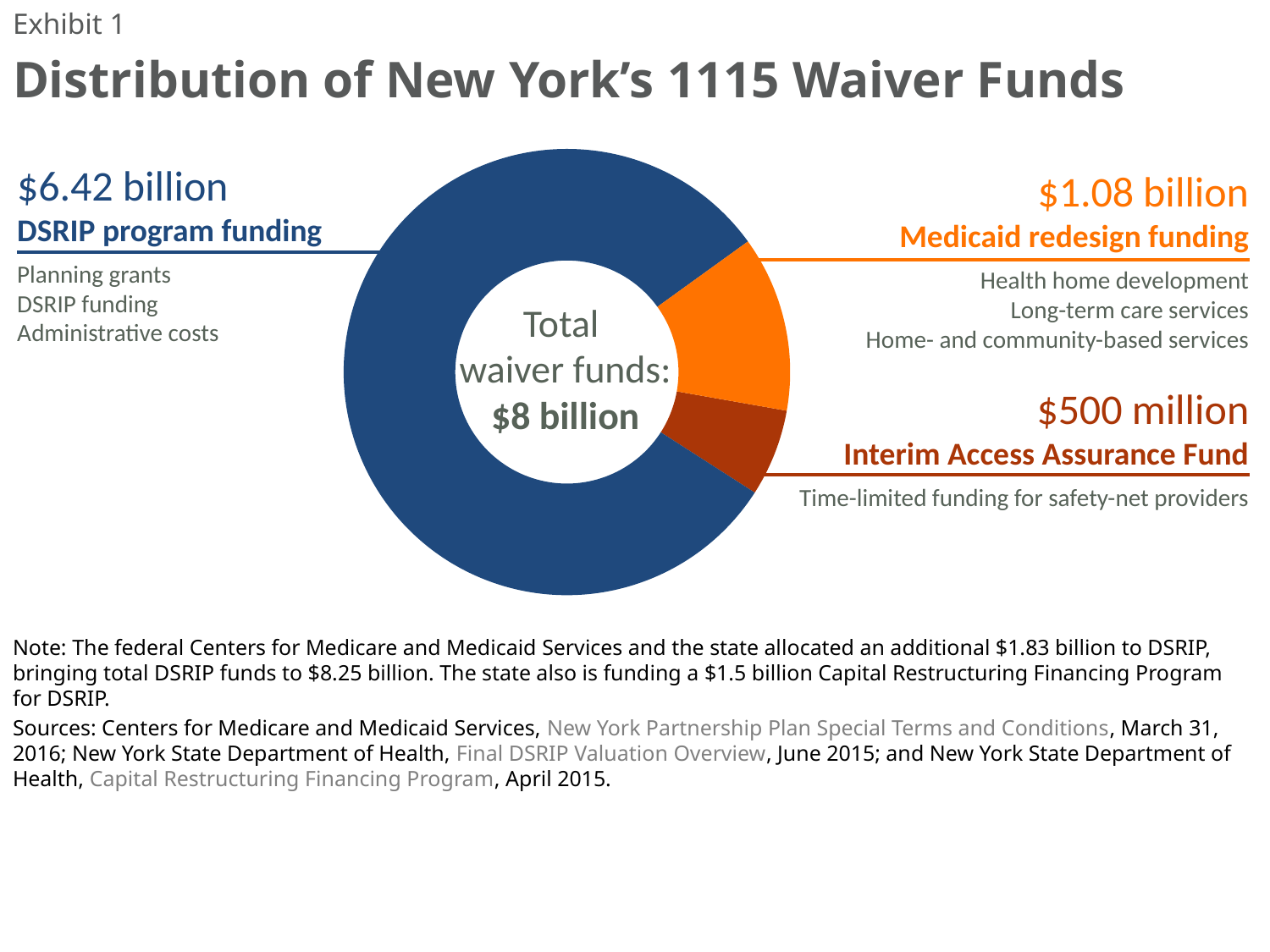
Which category receives the smallest share of the waiver funds? Interim Access Assurance Fund What is the value shown for Medicaid redesign funding? $1.08 billion How much larger is Medicaid redesign funding than the Interim Access Assurance Fund? $580 million What kind of chart is shown on the slide? pie chart (donut) What is the value shown for DSRIP program funding? $6.42 billion What is the total of waiver funds shown in the centre of the chart? $8 billion Which is larger, Medicaid redesign funding or the Interim Access Assurance Fund? Medicaid redesign funding Which category receives the largest share of the waiver funds? DSRIP program funding What is the value shown for the Interim Access Assurance Fund? $500 million How much larger is DSRIP program funding than Medicaid redesign funding? $5.34 billion How many segments does the chart divide the waiver funds into? 3 What share of the $8 billion total waiver funds goes to Medicaid redesign funding? 13.5%